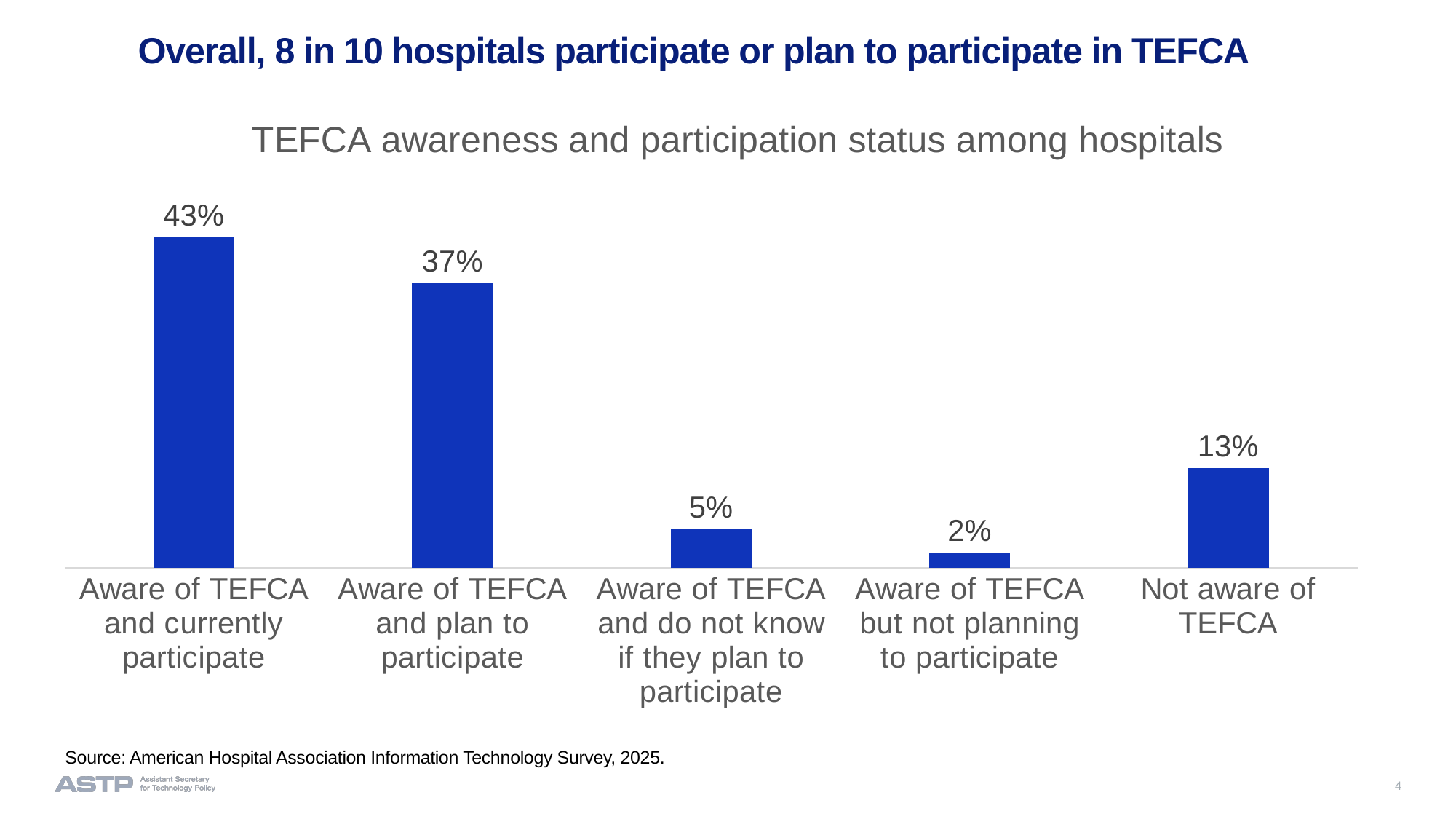
What percentage of hospitals are aware of TEFCA and do not know if they plan to participate? 5% What percentage of hospitals are aware of TEFCA and plan to participate? 37% What percentage of hospitals are aware of TEFCA but not planning to participate? 2% How many categories are shown in the chart? 5 Which is larger: the share of hospitals not aware of TEFCA or the share aware of TEFCA and do not know if they plan to participate? Not aware of TEFCA Which category has the lowest value? Aware of TEFCA but not planning to participate What is the difference between the share of hospitals that are aware of TEFCA and currently participate and the share that are aware and plan to participate? 6% Which category has the highest value? Aware of TEFCA and currently participate What percentage of hospitals are not aware of TEFCA? 13% What percentage of hospitals are aware of TEFCA and currently participate? 43% What type of chart is shown on the slide? Bar chart What is the title of the chart? TEFCA awareness and participation status among hospitals